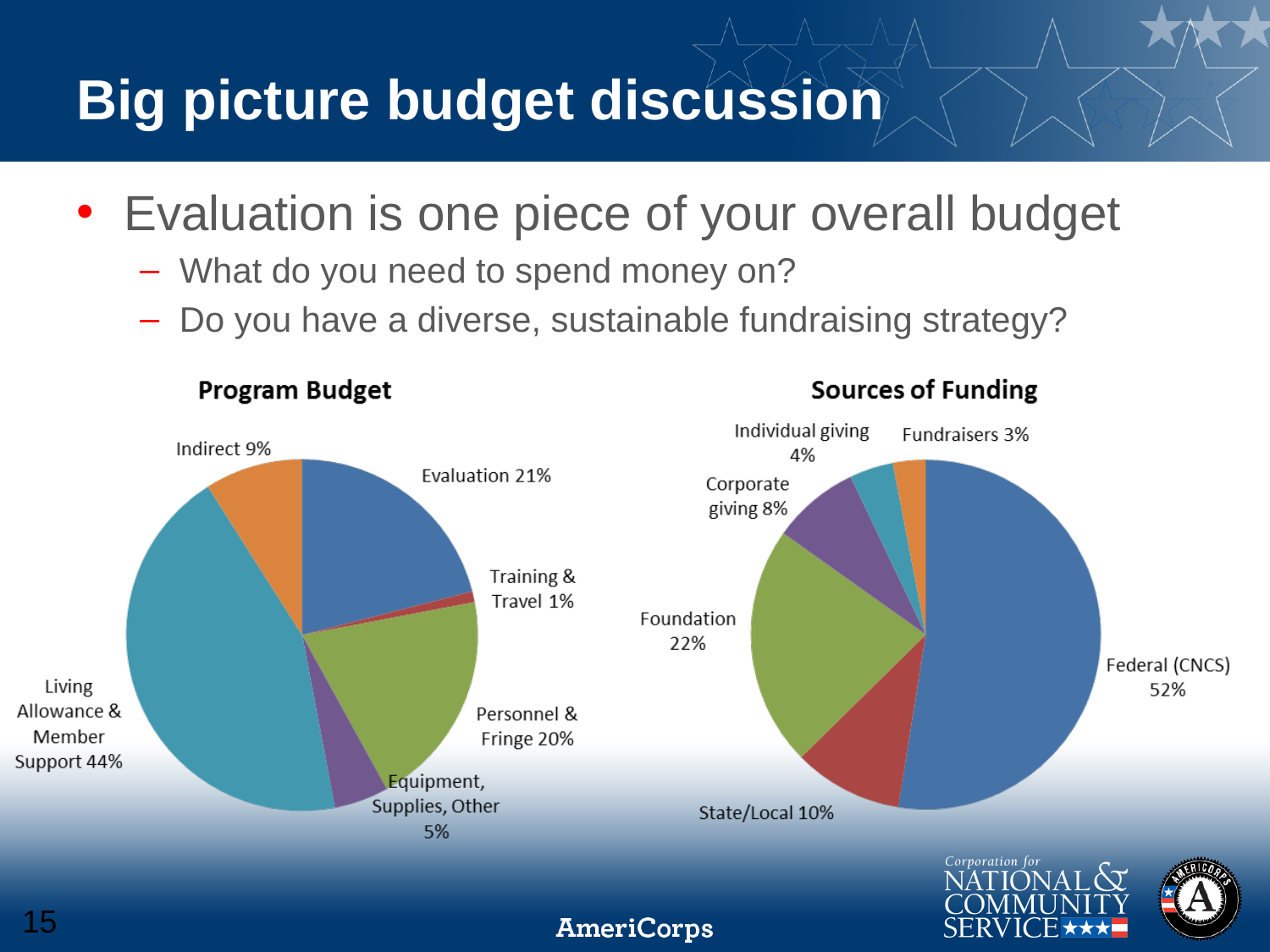
In the Sources of Funding chart, what share comes from Federal (CNCS)? 52% What type of chart is the Sources of Funding chart? Pie chart In the Program Budget chart, how many categories are shown? 6 In the Sources of Funding chart, which source has the smallest share? Fundraisers What is the title of the chart on the left side of the slide? Program Budget In the Sources of Funding chart, how many funding sources are shown? 6 In the Program Budget chart, which category has the largest share? Living Allowance & Member Support In the Program Budget chart, what share of the budget is Evaluation? 21% In the Program Budget chart, what is the difference between the Evaluation share and the Personnel & Fringe share? 1% In the Sources of Funding chart, which is larger: Foundation or State/Local? Foundation In the Program Budget chart, which category has the smallest share? Training & Travel In the Sources of Funding chart, what is the difference between the Federal (CNCS) share and the Foundation share? 30%